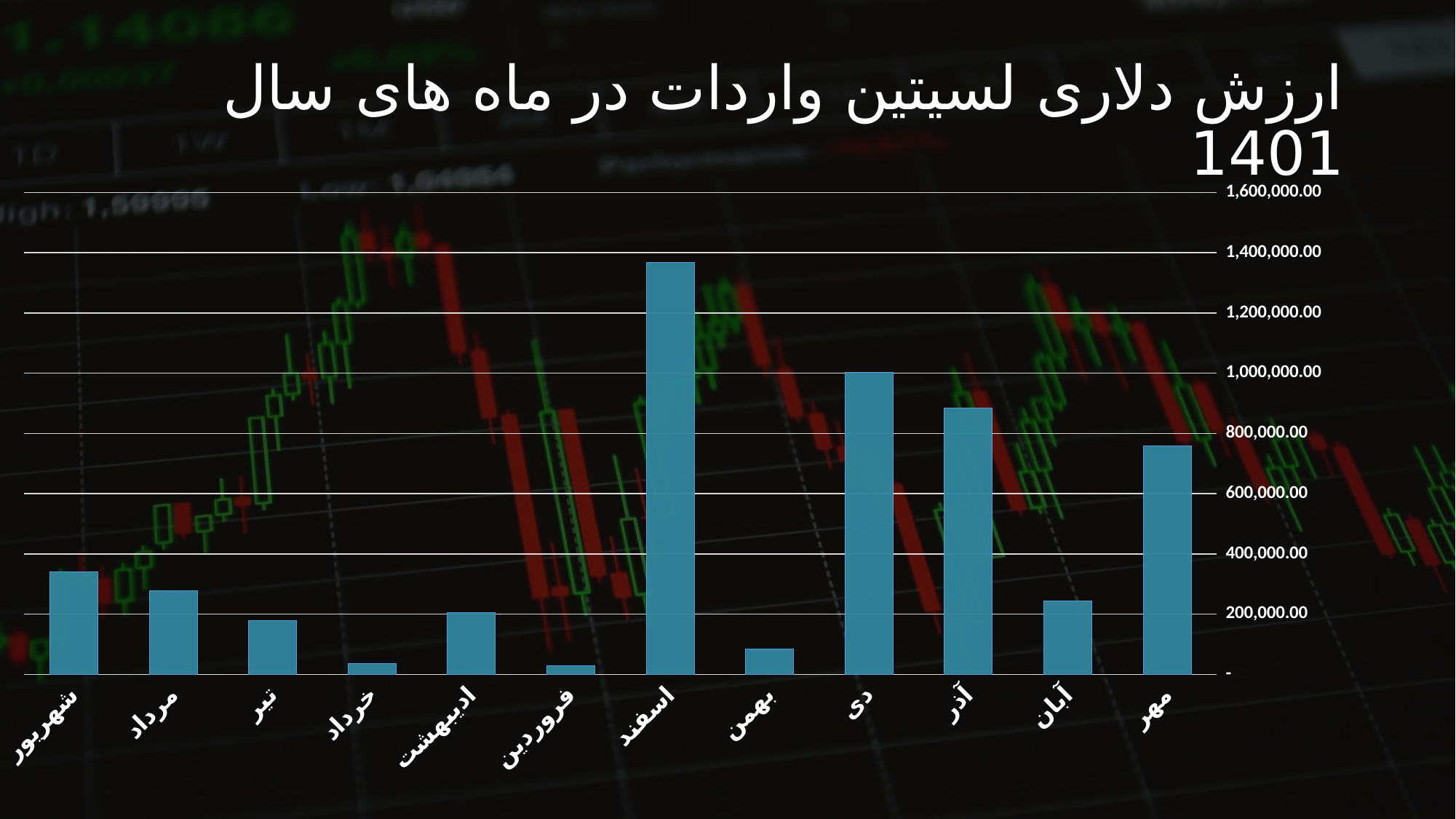
What is the title of the chart? ارزش دلاری لسیتین واردات در ماه های سال 1401 Is the value for شهریور greater or less than 200,000.00? greater Is the value for مهر greater or less than 600,000.00? greater Which is larger, the value for شهریور or the value for مرداد? شهریور Is the value for اسفند greater or less than 1,200,000.00? greater Which is larger, the value for مهر or the value for آذر? آذر Which month has the highest bar? اسفند Which is larger, the value for اسفند or the value for دی? اسفند How many months (categories) are plotted on the x axis? 12 What kind of chart is shown on the slide? bar chart